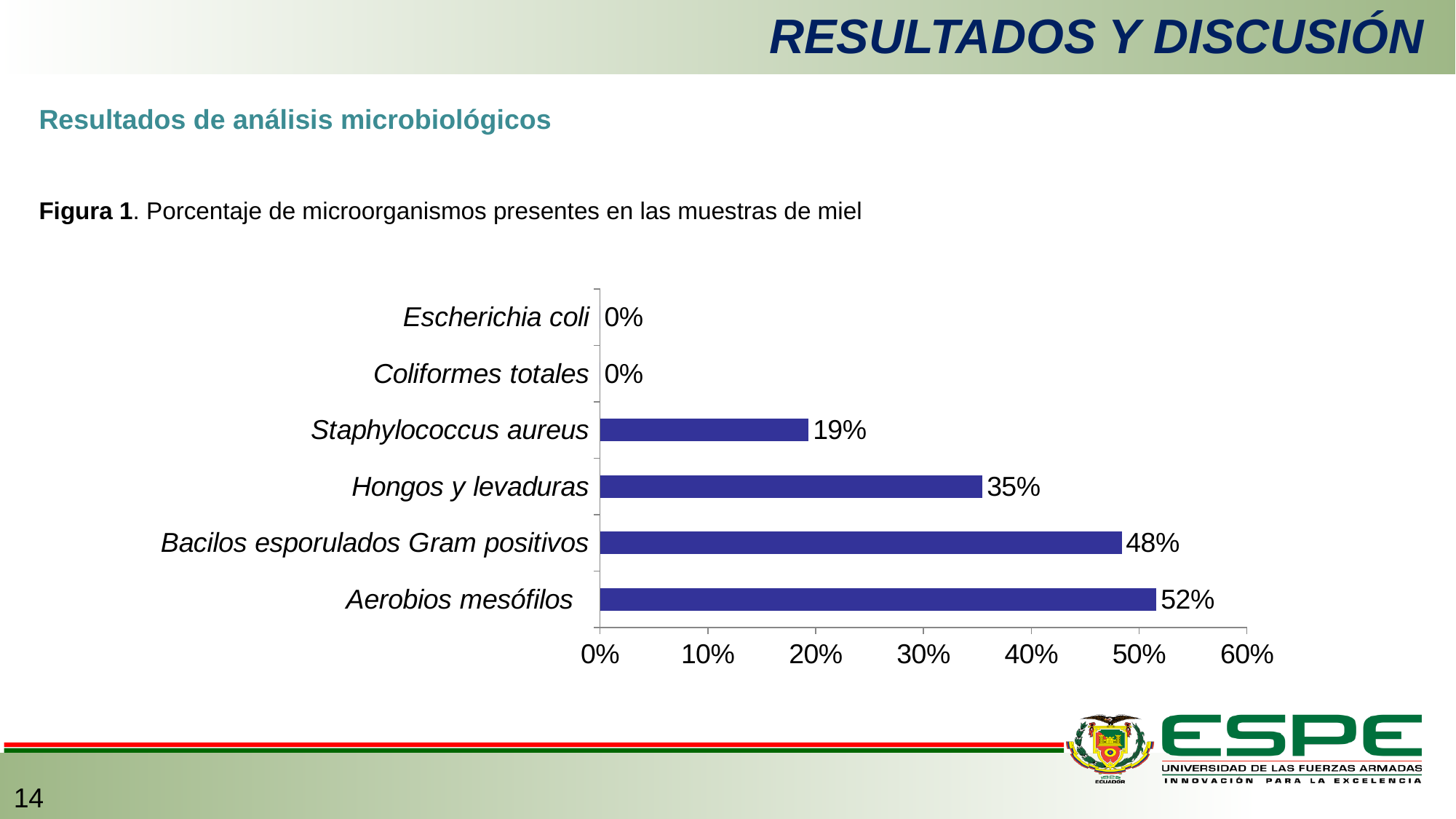
What is the value for Hongos y levaduras? 35% What kind of chart is shown on the slide? Bar chart Which category has the highest value? Aerobios mesófilos What is the value for Coliformes totales? 0% Is the value for Bacilos esporulados Gram positivos greater or less than 40%? greater What is the difference between the values for Aerobios mesófilos and Bacilos esporulados Gram positivos? 4% How many categories have a value of 0%? 2 What is the difference between the values for Hongos y levaduras and Staphylococcus aureus? 16% Which is larger, the value for Hongos y levaduras or the value for Staphylococcus aureus? Hongos y levaduras How many categories are shown in the chart? 6 What is the value for Staphylococcus aureus? 19% What is the value for Aerobios mesófilos? 52%